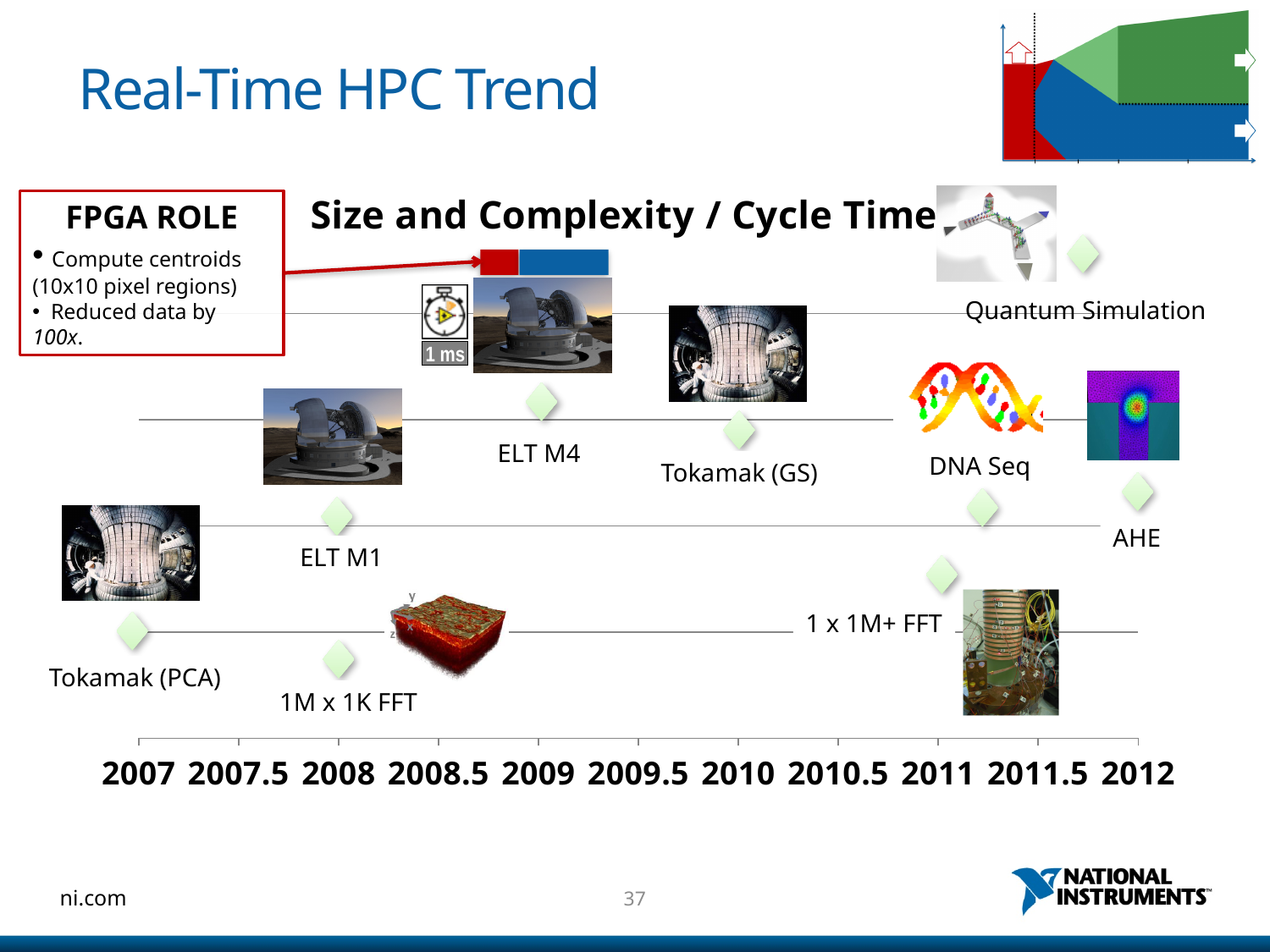
Is Quantum Simulation plotted at a year greater or less than 2011.5? greater What is the earliest year shown on the x axis of the chart? 2007 How many labeled data points are plotted on the chart? 9 In which year is Tokamak (GS) plotted on the timeline? 2010 What is the title of the chart on the slide? Size and Complexity / Cycle Time Which project is plotted at the earliest point on the timeline? Tokamak (PCA) In which year is 1 x 1M+ FFT plotted on the timeline? 2011 What kind of chart is shown on the slide? scatter chart (timeline) Is 1M x 1K FFT plotted at a year greater or less than 2009? less Which is plotted later on the timeline, ELT M1 or Tokamak (GS)? Tokamak (GS) Which project is plotted at the latest point on the timeline? AHE In which year is ELT M4 plotted on the timeline? 2009